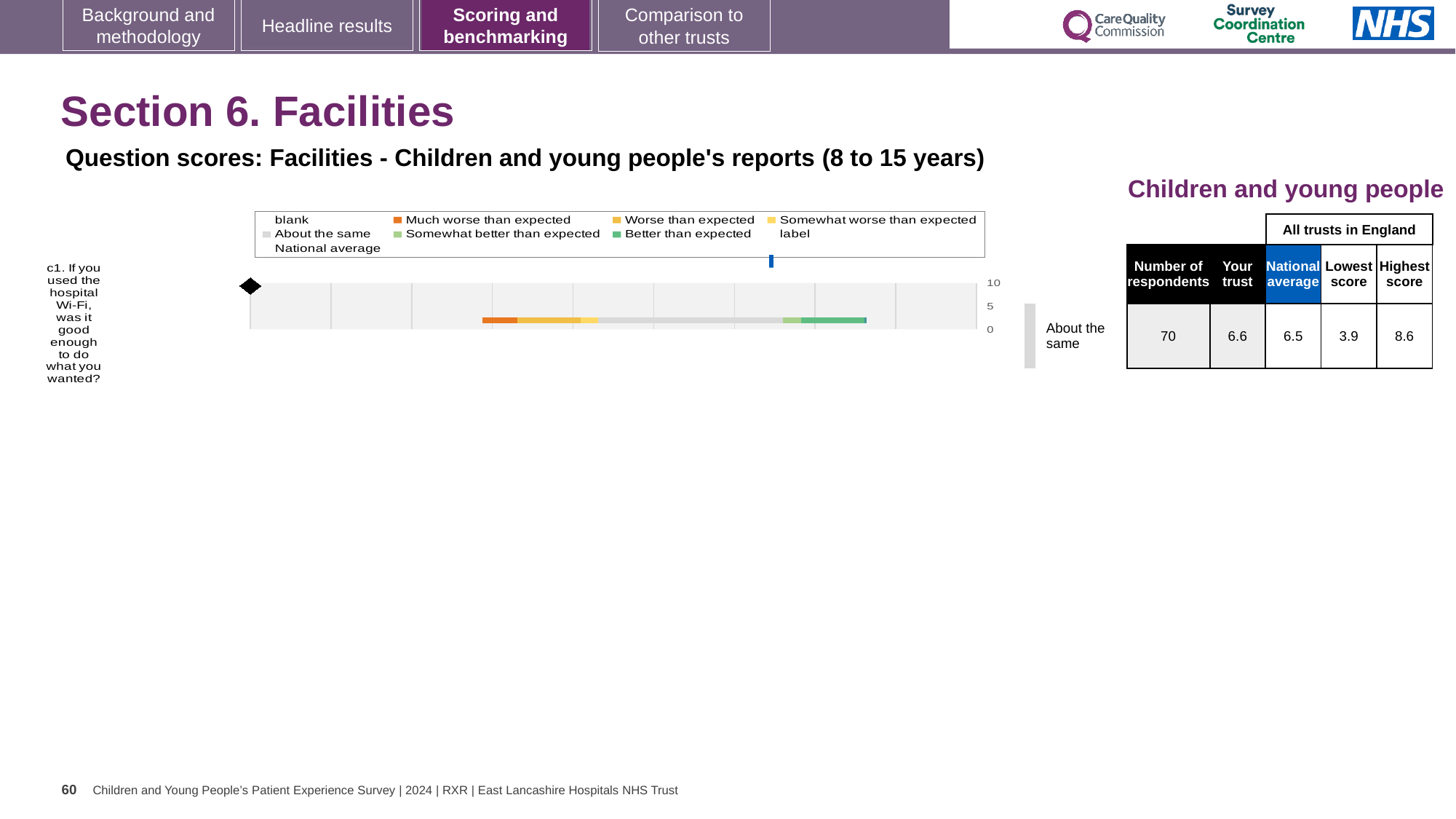
Is the 'Your trust' score for question c1 greater or less than 5? greater What is the lowest score among all trusts in England for question c1? 3.9 What is the difference between the highest score and the lowest score for question c1? 4.7 How many respondents answered question c1 (hospital Wi-Fi)? 70 What is the national average score for question c1 (hospital Wi-Fi)? 6.5 How many survey questions are plotted in the chart on this slide? 1 What kind of chart is used to show the question score for c1 on this slide? bar chart What is the highest score among all trusts in England for question c1? 8.6 What is the highest value shown on the chart's score axis? 10 In the chart legend, which colour represents 'Much worse than expected'? orange What is the 'Your trust' score for question c1 (hospital Wi-Fi)? 6.6 Which is larger for question c1: the 'Your trust' score or the national average? Your trust